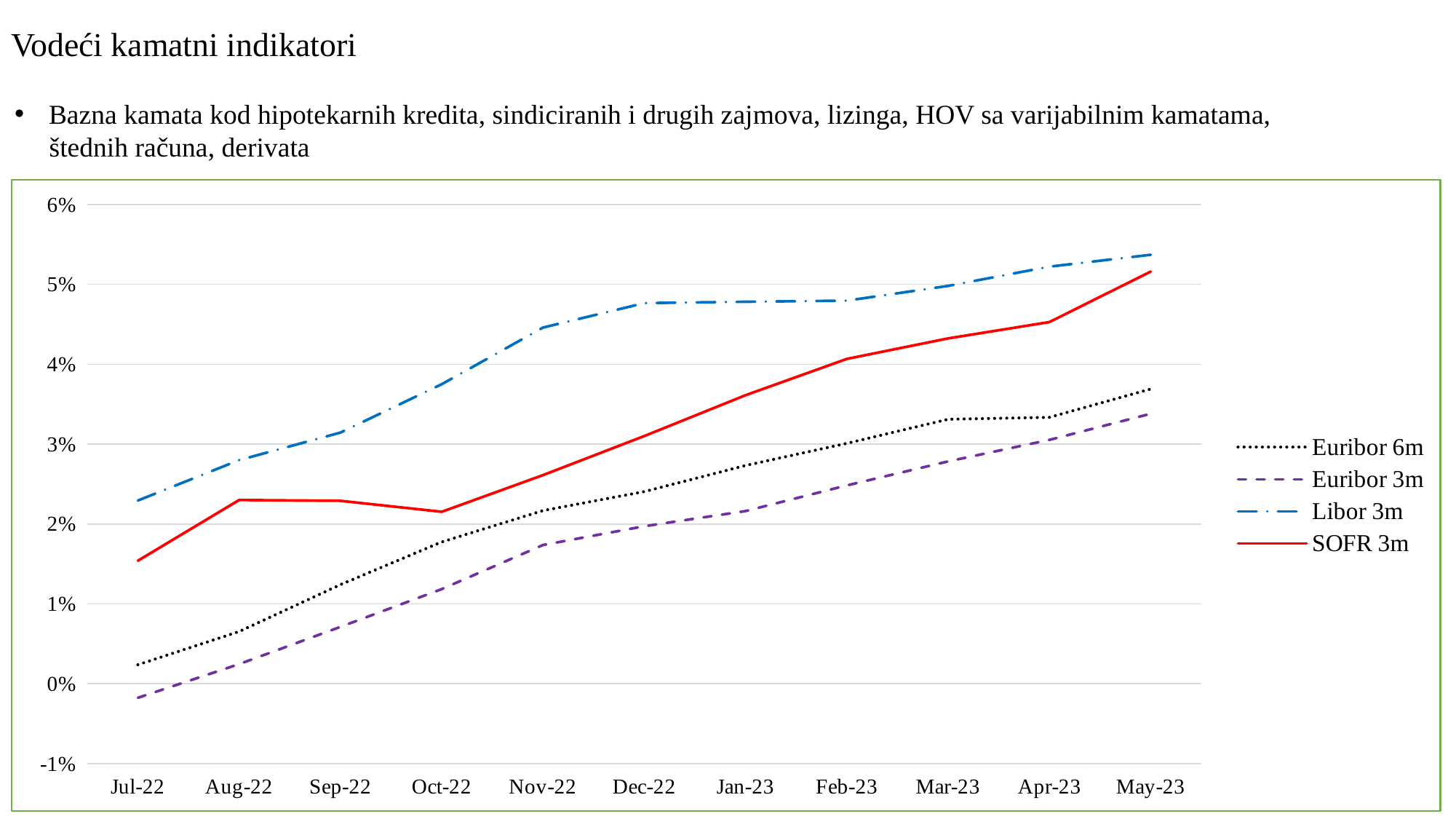
What kind of chart is shown on the slide? line chart In Jul-22, which is higher: Libor 3m or SOFR 3m? Libor 3m Is the value for Euribor 6m in Oct-22 greater or less than 2%? less How many series does the chart legend list? 4 Does the Euribor 3m series rise or fall from Jul-22 to May-23? rise How many months are shown along the x axis of the chart? 11 Which series is drawn as a solid red line in the chart? SOFR 3m Which series has the highest value in May-23? Libor 3m Which series has the lowest value in Jul-22? Euribor 3m Is the value for SOFR 3m in Jul-22 greater or less than 2%? less Is the value for Libor 3m in May-23 greater or less than 5%? greater